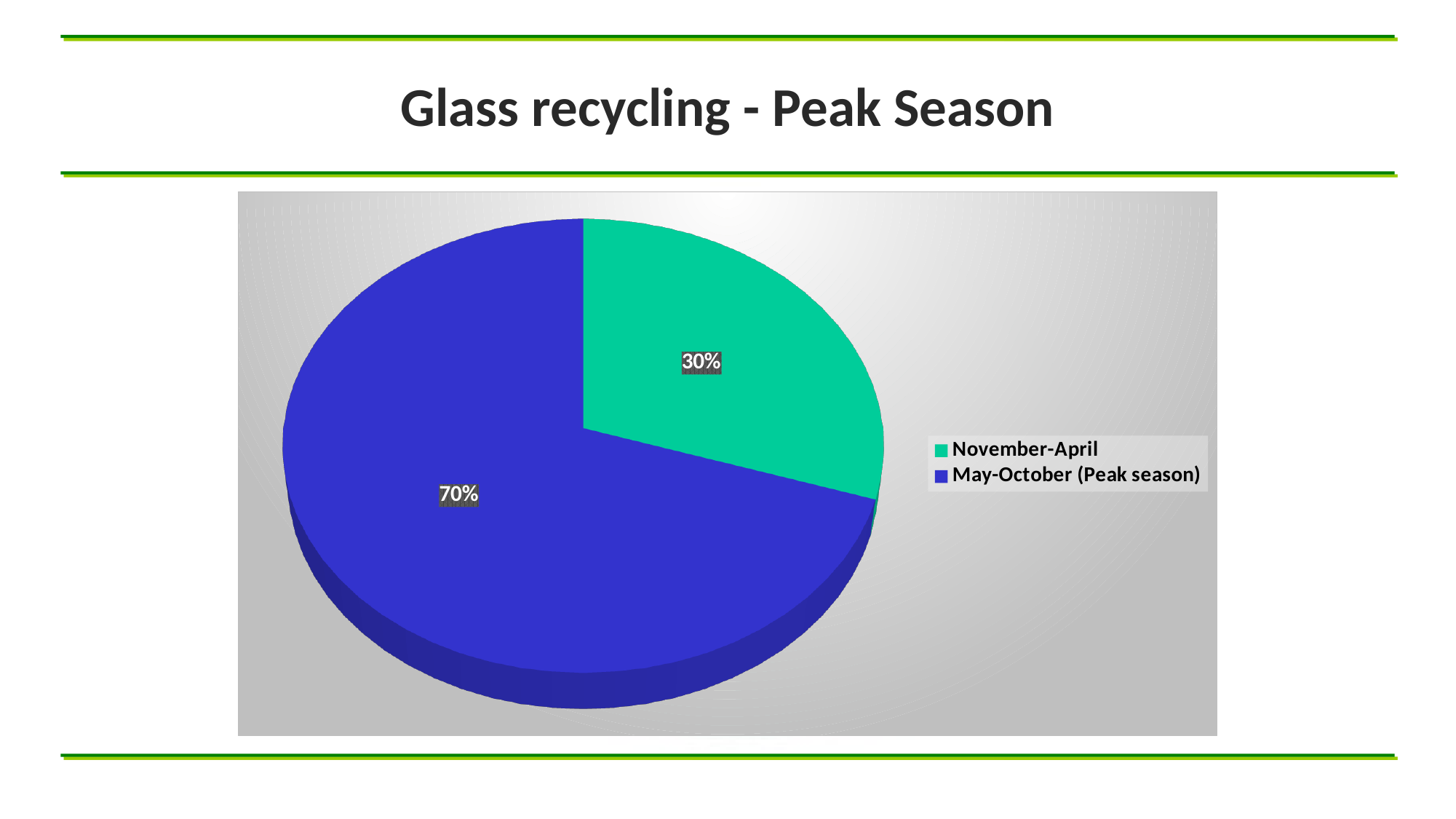
What kind of chart is shown on the slide? Pie chart Which category has the smallest slice of the pie? November-April What share of the pie does the November-April slice represent? 30% What colour is the May-October (Peak season) slice? Blue How many slices does the pie chart have? 2 How many entries does the legend list? 2 Which category has the largest slice of the pie? May-October (Peak season) What is the title of the slide containing the chart? Glass recycling - Peak Season What share of the pie does the May-October (Peak season) slice represent? 70% Which is larger, the November-April slice or the May-October (Peak season) slice? May-October (Peak season) What is the difference in percentage points between the May-October (Peak season) slice and the November-April slice? 40%